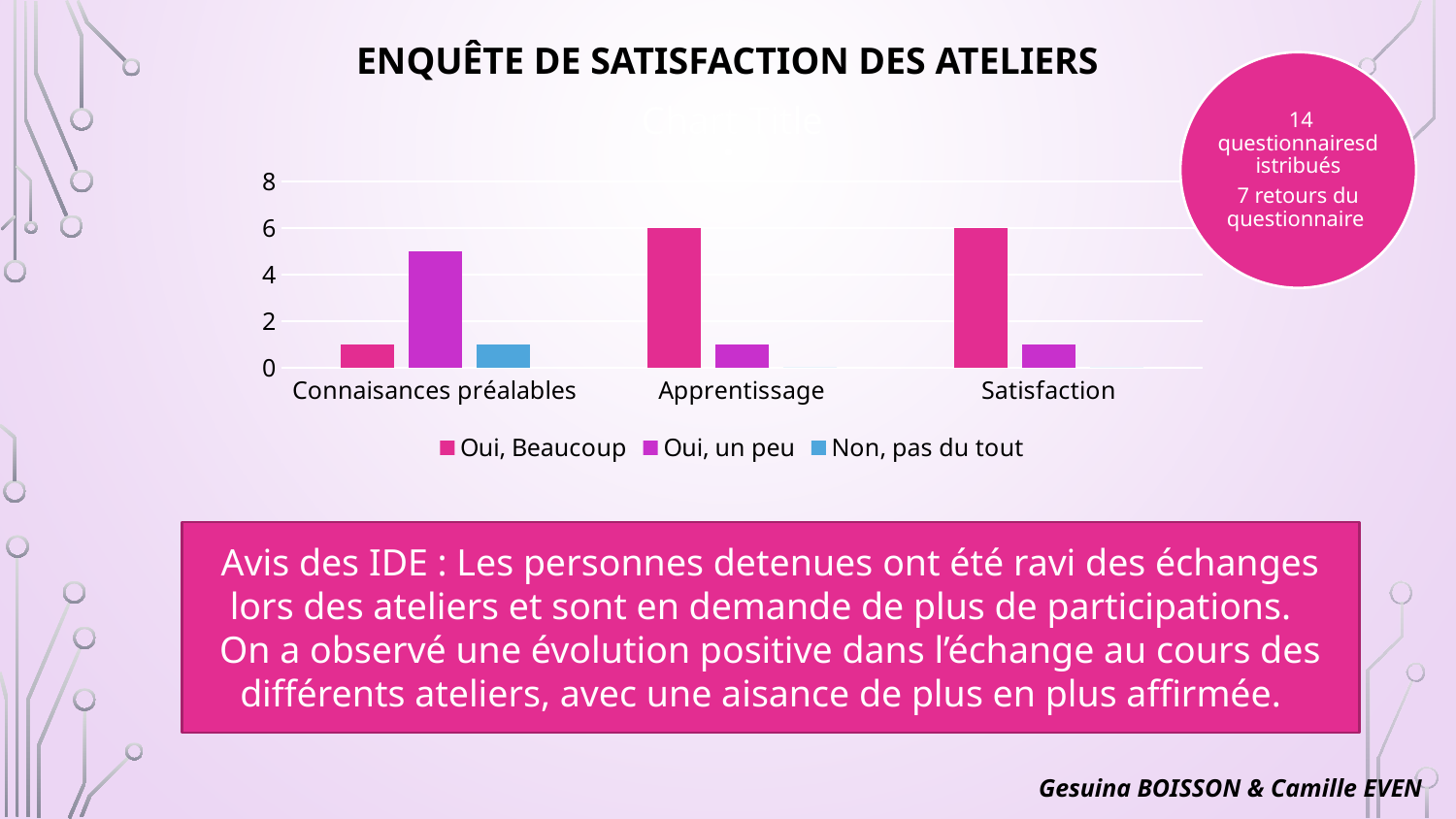
Which legend entry is shown in blue? Non, pas du tout Is the value of 'Oui, un peu' for Connaisances préalables greater or less than 4? greater How many series does the chart legend list? 3 How many categories are shown on the x axis of the chart? 3 Which series has the highest bar in the Connaisances préalables category? Oui, un peu What kind of chart is shown on the slide? bar chart In the Apprentissage category, which is larger: 'Oui, Beaucoup' or 'Oui, un peu'? Oui, Beaucoup What is the title of the slide containing the chart? ENQUÊTE DE SATISFACTION DES ATELIERS What is the value of 'Oui, Beaucoup' for Apprentissage? 6 Is the value of 'Oui, Beaucoup' for Connaisances préalables greater or less than 2? less What is the value of 'Oui, Beaucoup' for Satisfaction? 6 Which category has the lowest 'Oui, Beaucoup' value? Connaisances préalables